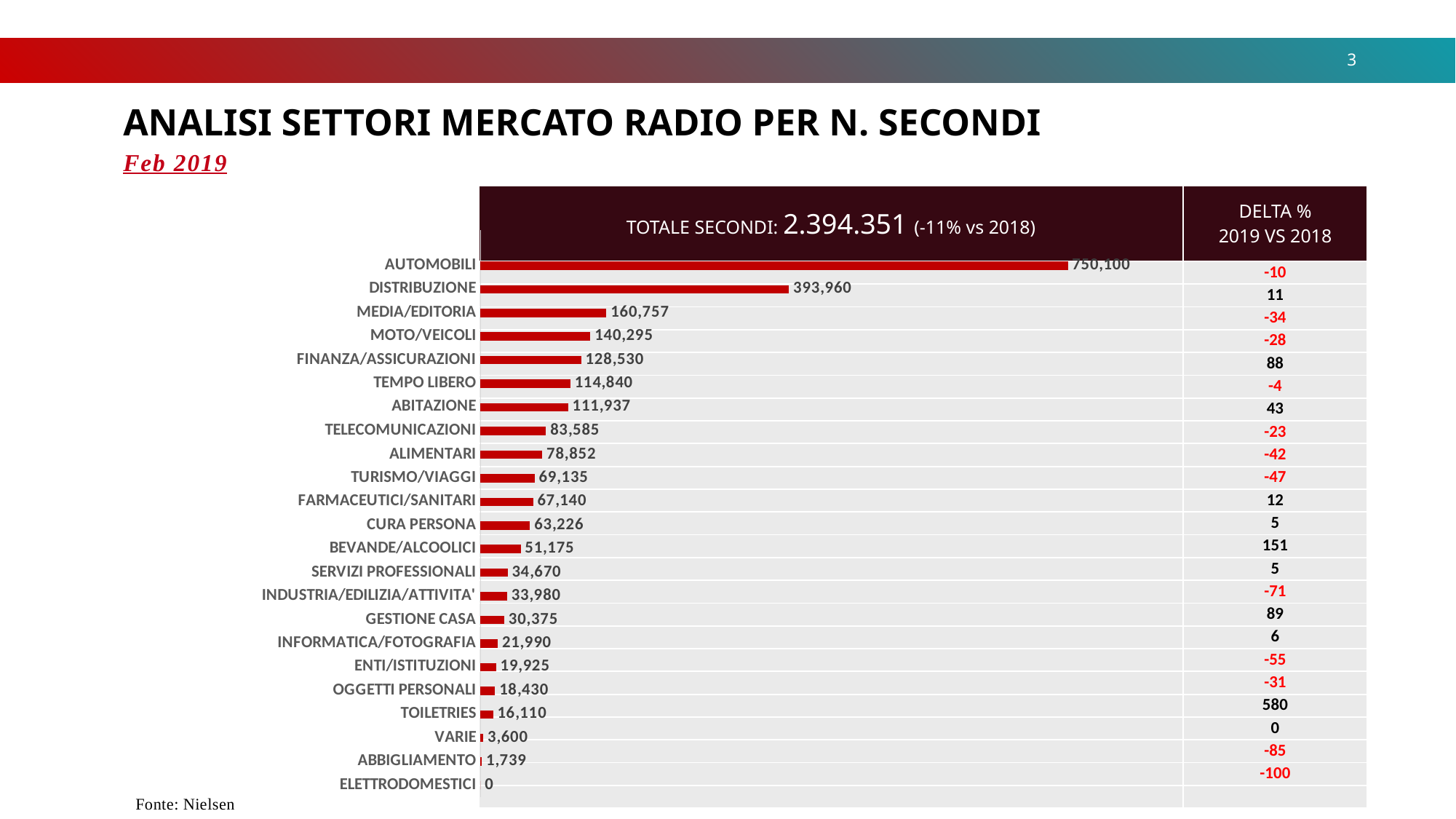
What is the DELTA % 2019 VS 2018 shown for TOILETRIES? 580 What is the value for GESTIONE CASA? 30,375 What total number of seconds is stated in the chart header? 2.394.351 What kind of chart is shown on the slide? bar chart What is the difference between the values for MEDIA/EDITORIA and MOTO/VEICOLI? 20,462 What is the value for DISTRIBUZIONE? 393,960 Which category has the highest value? AUTOMOBILI What is the difference between the values for AUTOMOBILI and DISTRIBUZIONE? 356,140 Which is larger, the value for TEMPO LIBERO or the value for ABITAZIONE? TEMPO LIBERO Which category has the lowest value? ELETTRODOMESTICI What is the value for TELECOMUNICAZIONI? 83,585 How many categories are shown in the chart? 23